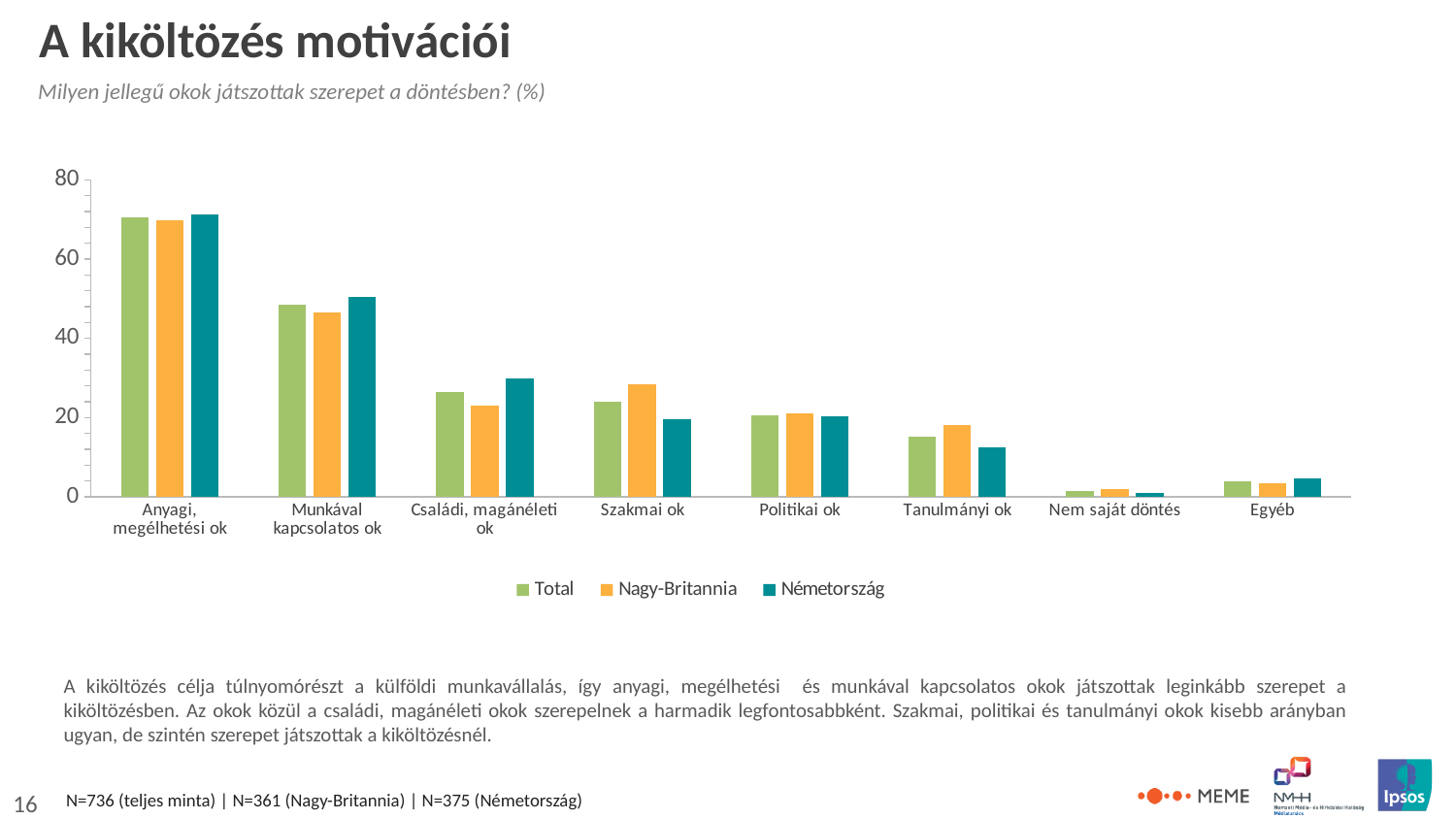
How many categories are shown on the x axis of the chart? 8 For Családi, magánéleti ok, which is larger: the Nagy-Britannia value or the Németország value? Németország Is the Total value for Anyagi, megélhetési ok greater or less than 60? greater Which category has the lowest Total value? Nem saját döntés Is the Total value for Munkával kapcsolatos ok greater or less than 40? greater Is the Németország value for Tanulmányi ok greater or less than 20? less For Szakmai ok, which is larger: the Nagy-Britannia value or the Németország value? Nagy-Britannia Which category has the highest Total value? Anyagi, megélhetési ok What kind of chart is shown on the slide? bar chart How many series does the legend list? 3 What are the three series listed in the legend? Total, Nagy-Britannia, Németország